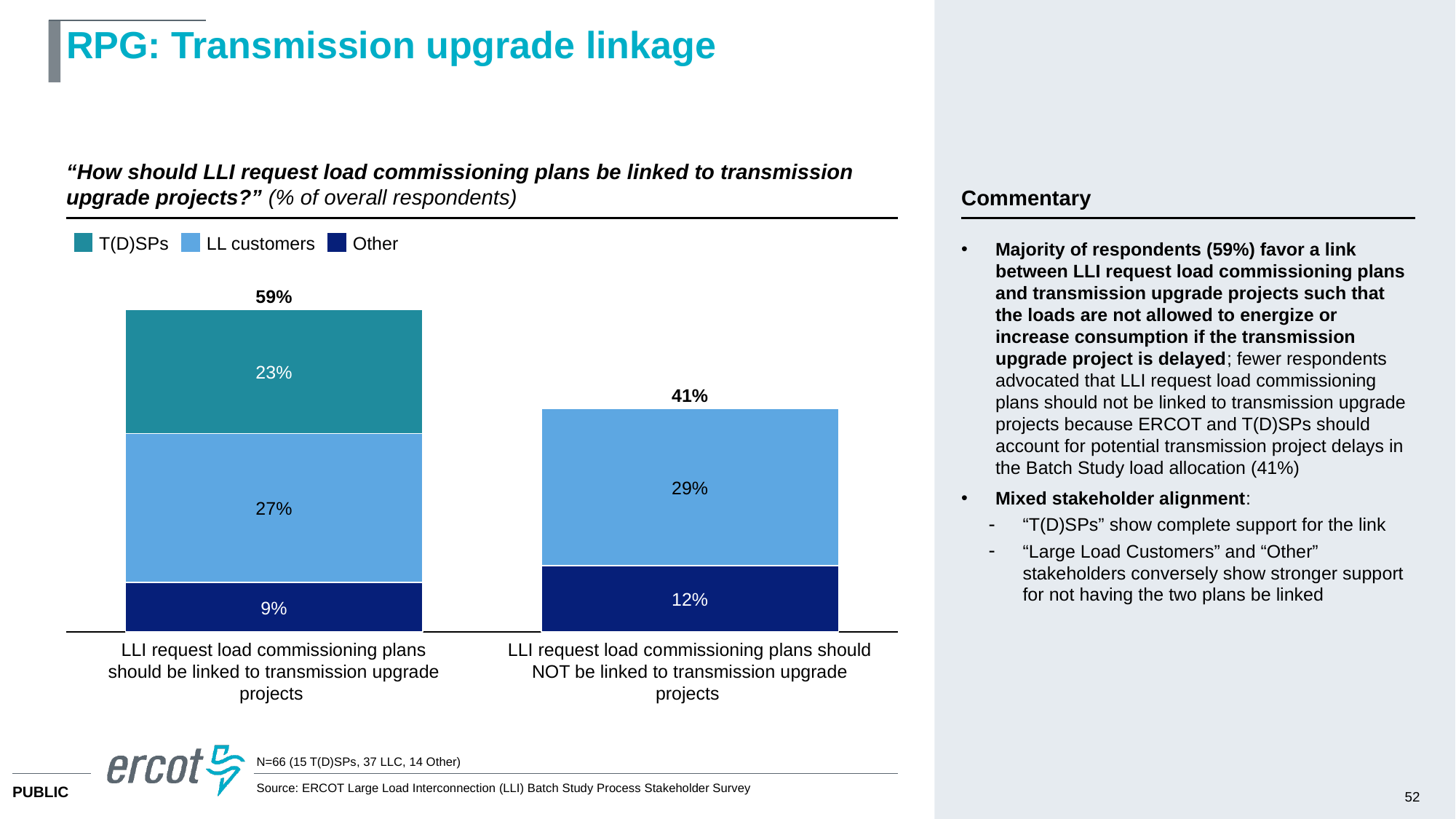
What is the Other value for 'LLI request load commissioning plans should NOT be linked to transmission upgrade projects'? 12% What is the Other value for 'LLI request load commissioning plans should be linked to transmission upgrade projects'? 9% What is the difference between the LL customers values for the 'should NOT be linked' and 'should be linked' bars? 2% How many series does the legend list? 3 How many categories are shown on the x axis? 2 What is the total for the bar 'LLI request load commissioning plans should NOT be linked to transmission upgrade projects'? 41% What is the difference between the totals of the two bars? 18% What is the T(D)SPs value for 'LLI request load commissioning plans should be linked to transmission upgrade projects'? 23% Which category has the higher total, 'should be linked' or 'should NOT be linked'? LLI request load commissioning plans should be linked to transmission upgrade projects What kind of chart is shown on the slide? Stacked bar chart What is the total for the bar 'LLI request load commissioning plans should be linked to transmission upgrade projects'? 59% What is the LL customers value for 'LLI request load commissioning plans should NOT be linked to transmission upgrade projects'? 29%